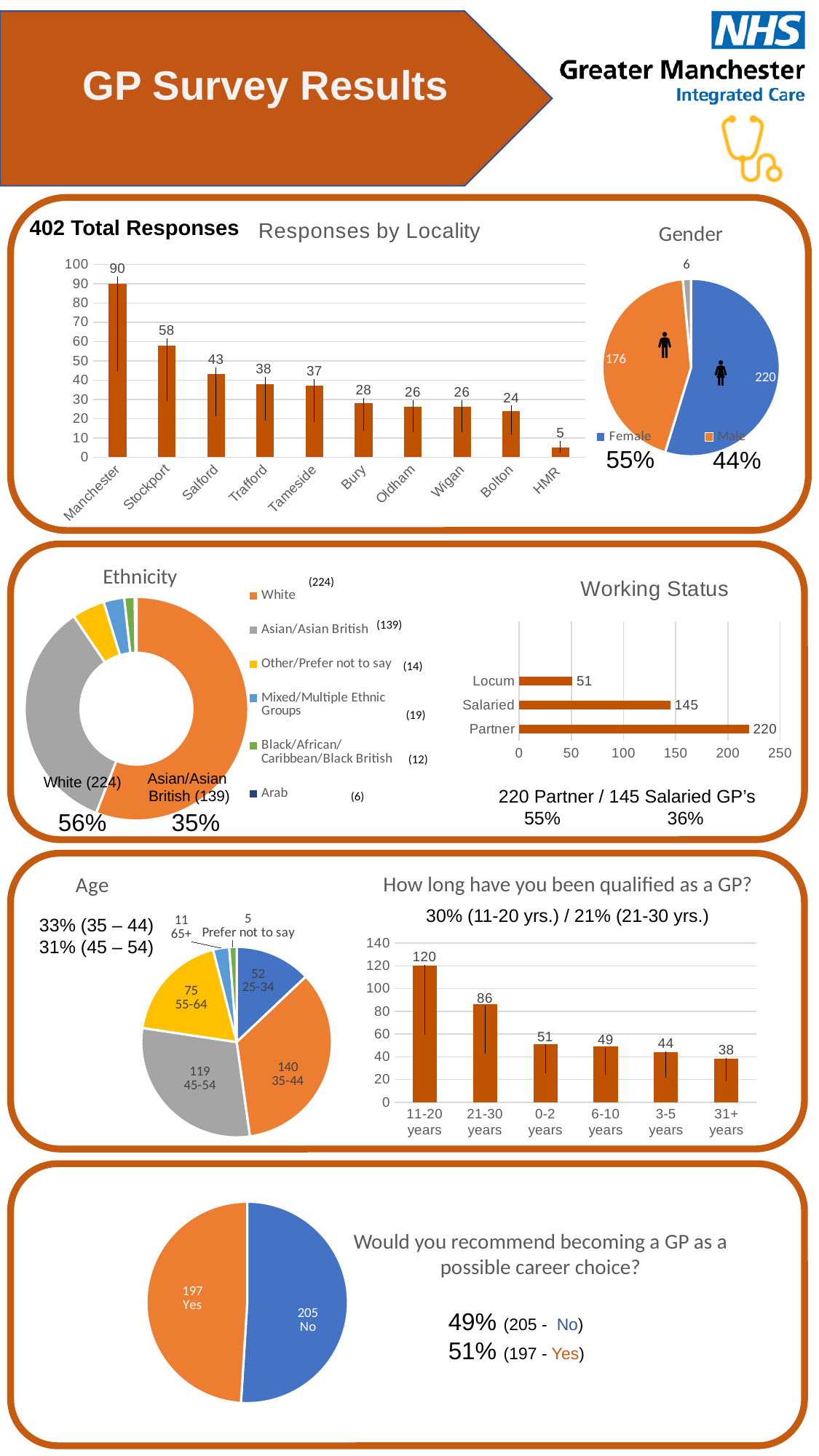
In the Age pie chart, which age group has the largest value? 35-44 In the Responses by Locality chart, which locality has the highest number of responses? Manchester In the Responses by Locality chart, which locality has the lowest number of responses? HMR In the Gender pie chart, what is the value for Female? 220 In the Working Status chart, what is the value for Salaried? 145 In the Responses by Locality chart, how many responses came from Stockport? 58 In the Responses by Locality chart, what is the difference between the Manchester and Salford values? 47 In the 'How long have you been qualified as a GP?' chart, which of 21-30 years or 0-2 years has the larger value? 21-30 years What kind of chart is the Working Status chart? bar chart In the Responses by Locality chart, how many localities are shown? 10 In the Gender pie chart, what percentage share is Male? 44% In the Ethnicity chart, what is the value for Asian/Asian British? 139